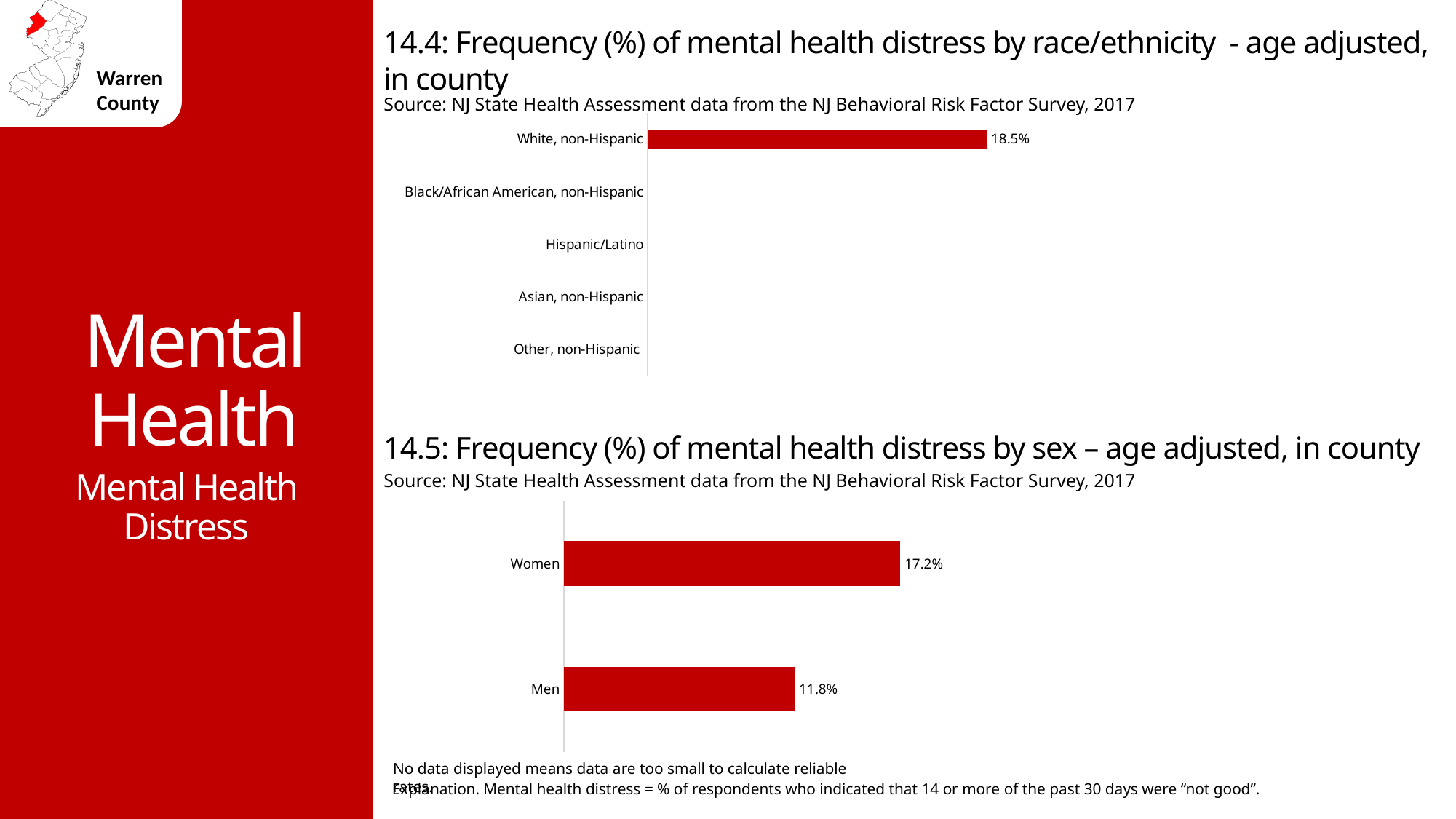
In chart 14.5 (mental health distress by sex), is the value for Women larger or smaller than the value for Men? Larger What kind of chart is chart 14.4 (mental health distress by race/ethnicity)? Bar chart What kind of chart is chart 14.5 (mental health distress by sex)? Bar chart In chart 14.4 (mental health distress by race/ethnicity), which category is the only one with a bar displayed? White, non-Hispanic In chart 14.5 (mental health distress by sex), how many categories are shown? 2 In chart 14.4 (mental health distress by race/ethnicity), what is the value for White, non-Hispanic? 18.5% In chart 14.5 (mental health distress by sex), what is the difference between the values for Women and Men? 5.4% In chart 14.5 (mental health distress by sex), which category has the higher value? Women In chart 14.4 (mental health distress by race/ethnicity), how many race/ethnicity categories are listed on the axis? 5 In chart 14.5 (mental health distress by sex), what is the value for Men? 11.8% In chart 14.5 (mental health distress by sex), which category has the lower value? Men In chart 14.5 (mental health distress by sex), what is the value for Women? 17.2%